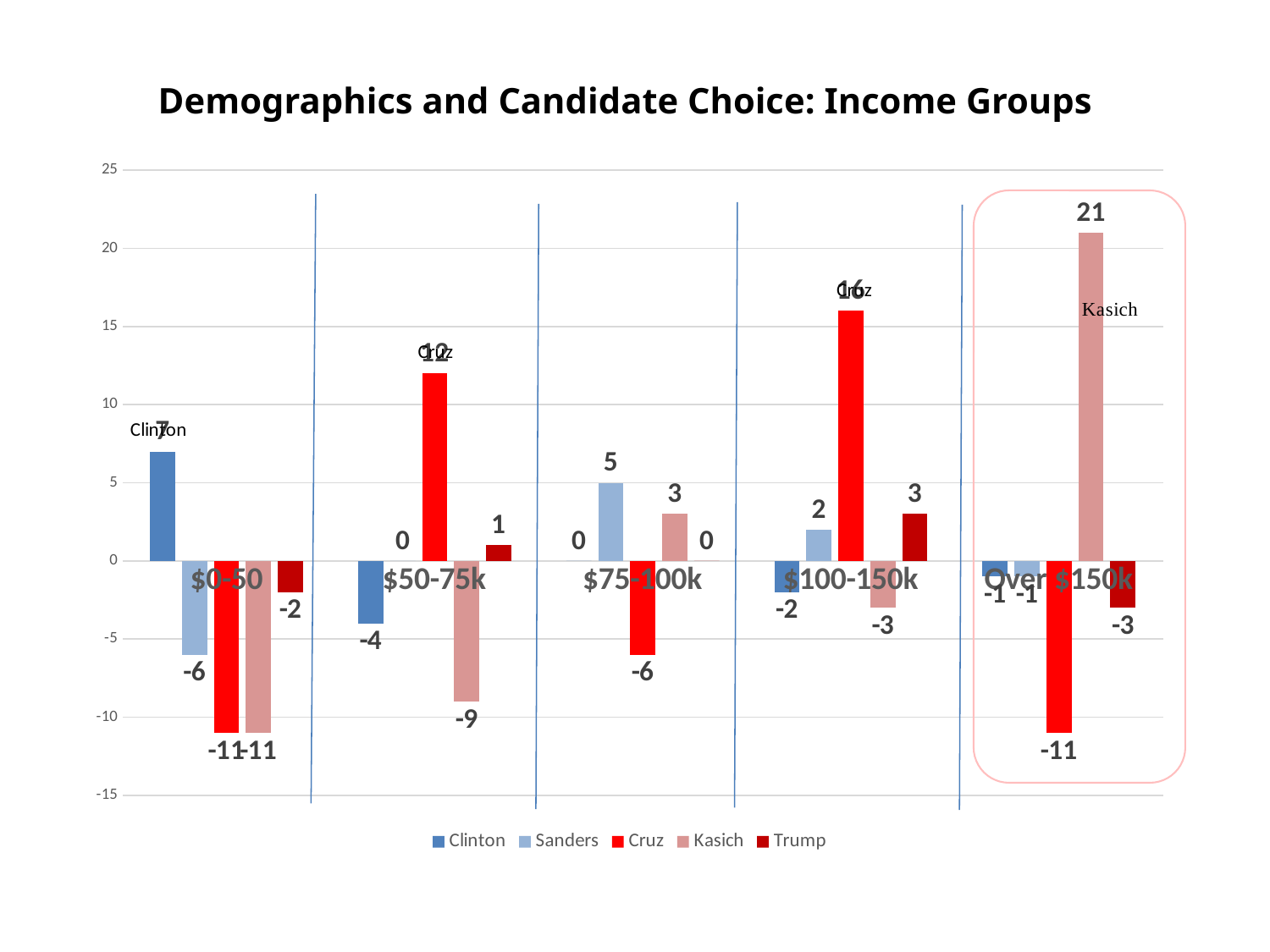
Which is larger in the $0-50 income group, the value for Clinton or the value for Sanders? Clinton Which candidate has the lowest value in the $50-75k income group? Kasich What is the value for Sanders in the $75-100k income group? 5 What is the difference between the Sanders value and the Cruz value in the $75-100k income group? 11 How many series does the legend list? 5 Which candidate has the highest value in the Over $150k income group? Kasich What kind of chart is shown on the slide? Bar chart What is the value for Kasich in the $50-75k income group? -9 How many income groups are shown on the x axis? 5 What is the value for Kasich in the Over $150k income group? 21 Is the value for Cruz in the $100-150k income group greater or less than 15? greater What is the value for Trump in the $100-150k income group? 3